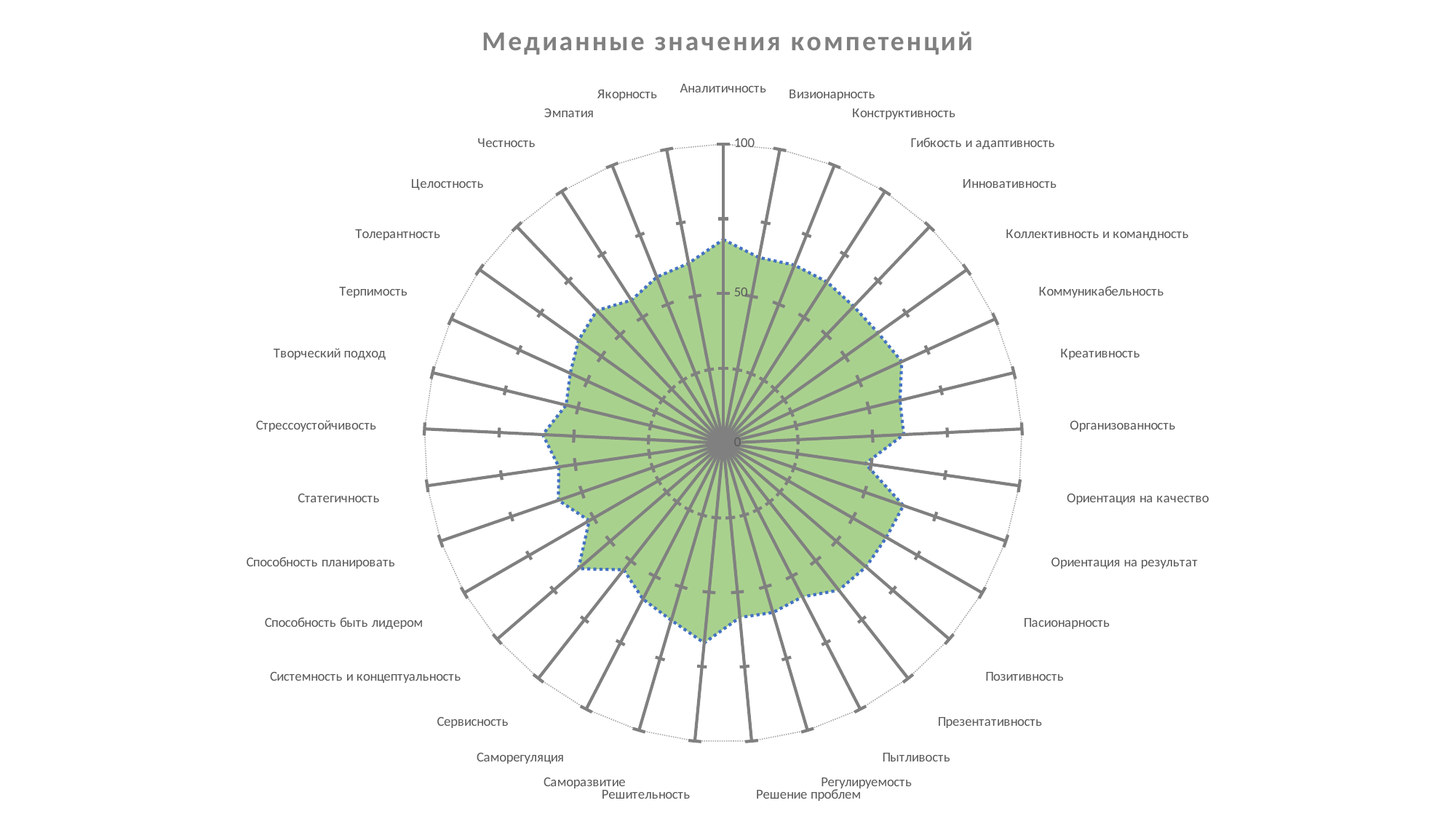
Is the value for Честность greater or less than 50? greater Is the value for Аналитичность greater or less than 50? greater What kind of chart is shown on the slide? radar chart What is the maximum value shown on the radial axis of the chart? 100 Is the value for Способность планировать greater or less than 50? greater How many competency categories are plotted around the radar chart? 33 What is the title of the chart? Медианные значения компетенций